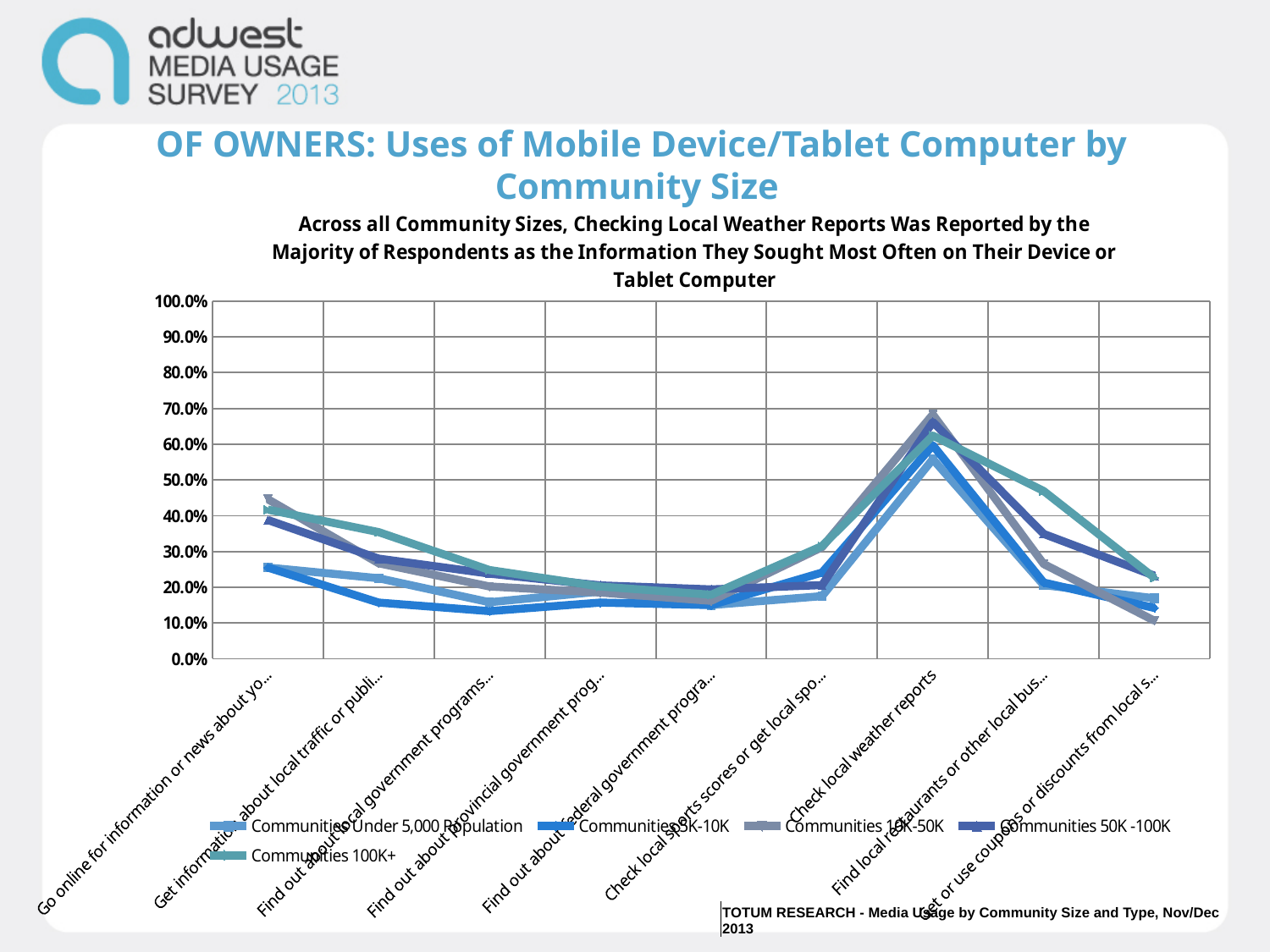
Is the value for Communities 10K-50K at "Check local weather reports" greater or less than 60%? greater Is the value for Communities 5K-10K at "Find out about provincial government prog..." greater or less than 20%? less Which series is shown in the lightest blue line, listed first in the legend? Communities Under 5,000 Population Is the value for Communities Under 5,000 Population at "Go online for information or news about yo..." greater or less than 30%? less For which category do all the community-size lines reach their highest value? Check local weather reports How many categories are plotted along the x axis? 9 At "Find local restaurants or other local bus...", which is larger: the value for Communities 100K+ or for Communities 5K-10K? Communities 100K+ What is the highest value shown on the y axis? 100.0% At "Check local weather reports", which is larger: the value for Communities 10K-50K or for Communities Under 5,000 Population? Communities 10K-50K What kind of chart is shown on the slide? Line chart How many series does the legend list? 5